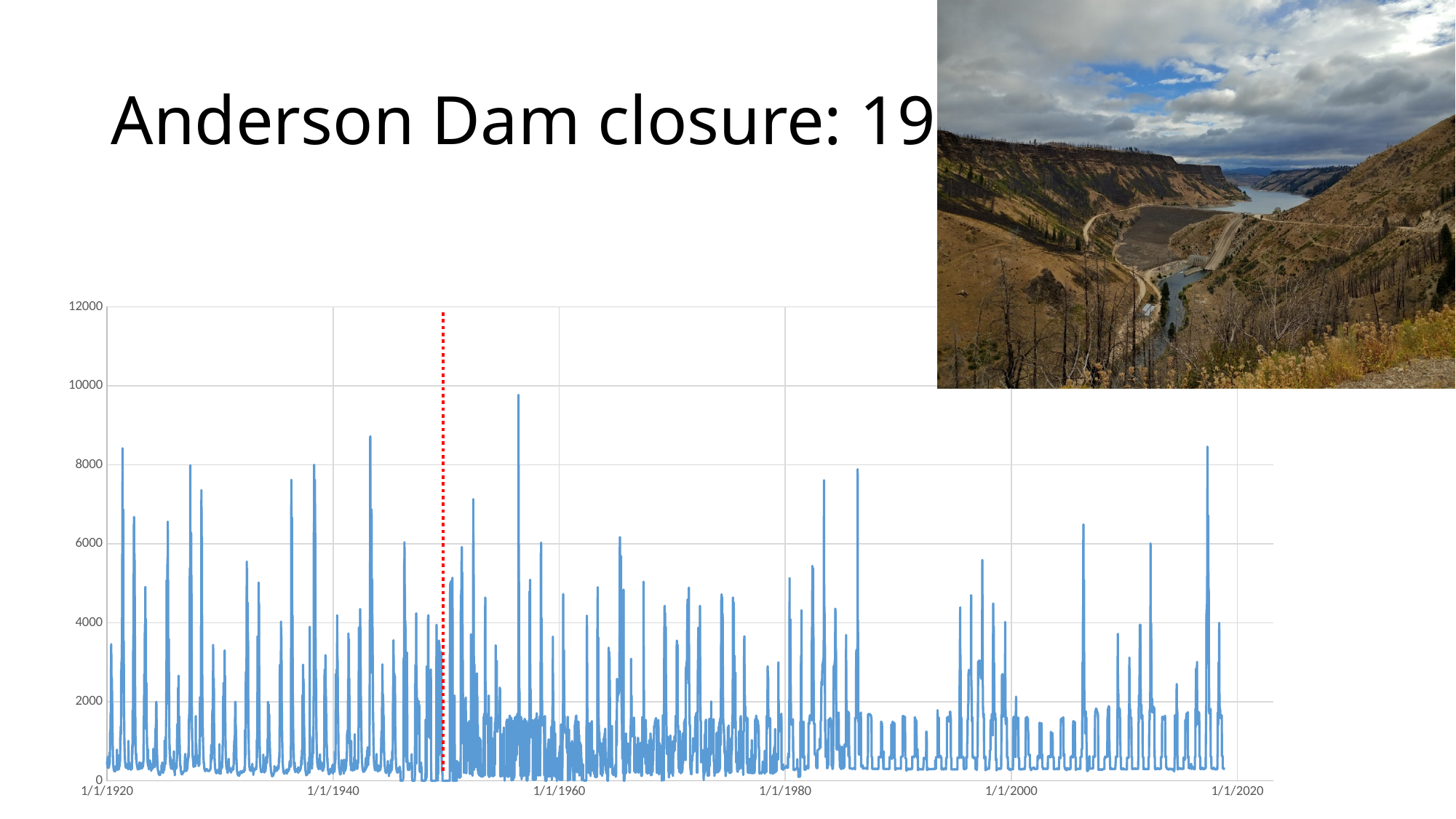
Is the tallest peak in the chart greater or less than 10000? less What is the last date label on the horizontal axis of the chart? 1/1/2020 What is the highest value labelled on the vertical axis of the chart? 12000 Between which two horizontal-axis labels does the tallest peak of the chart occur? 1/1/1940 and 1/1/1960 What is the first date label on the horizontal axis of the chart? 1/1/1920 Is the highest peak between 1/1/2000 and 1/1/2020 greater or less than 8000? greater What is the interval between consecutive labelled ticks on the vertical axis? 2000 Is the highest peak between 1/1/1960 and 1/1/1980 greater or less than 8000? less What kind of chart is shown on the slide? line chart How many date labels are shown on the horizontal axis of the chart? 6